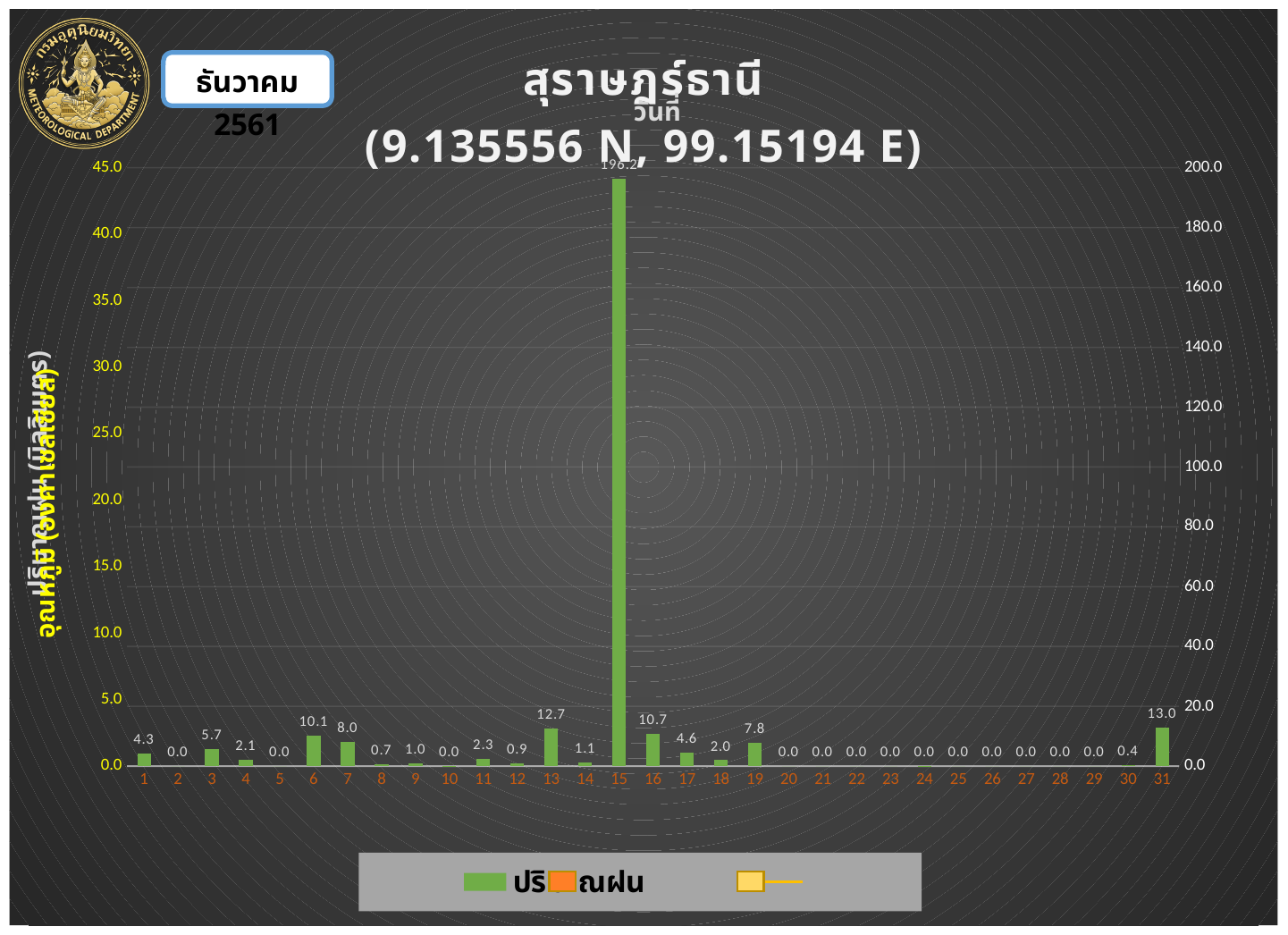
What type of chart is shown on the slide? bar chart How many days are shown on the x axis? 31 What is the rainfall value for day 31? 13.0 What is the rainfall value for day 15? 196.2 What is the rainfall value for day 6? 10.1 What is the difference between the rainfall values for day 15 and day 31? 183.2 Which is larger, the rainfall value for day 7 or for day 19? day 7 Is the rainfall value for day 15 greater or less than 180.0 on the right axis? greater What is the rainfall value for day 13? 12.7 What is the difference between the rainfall values for day 13 and day 16? 2.0 Which day has the highest rainfall value? 15 What are the coordinates shown in the chart title? 9.135556 N, 99.15194 E